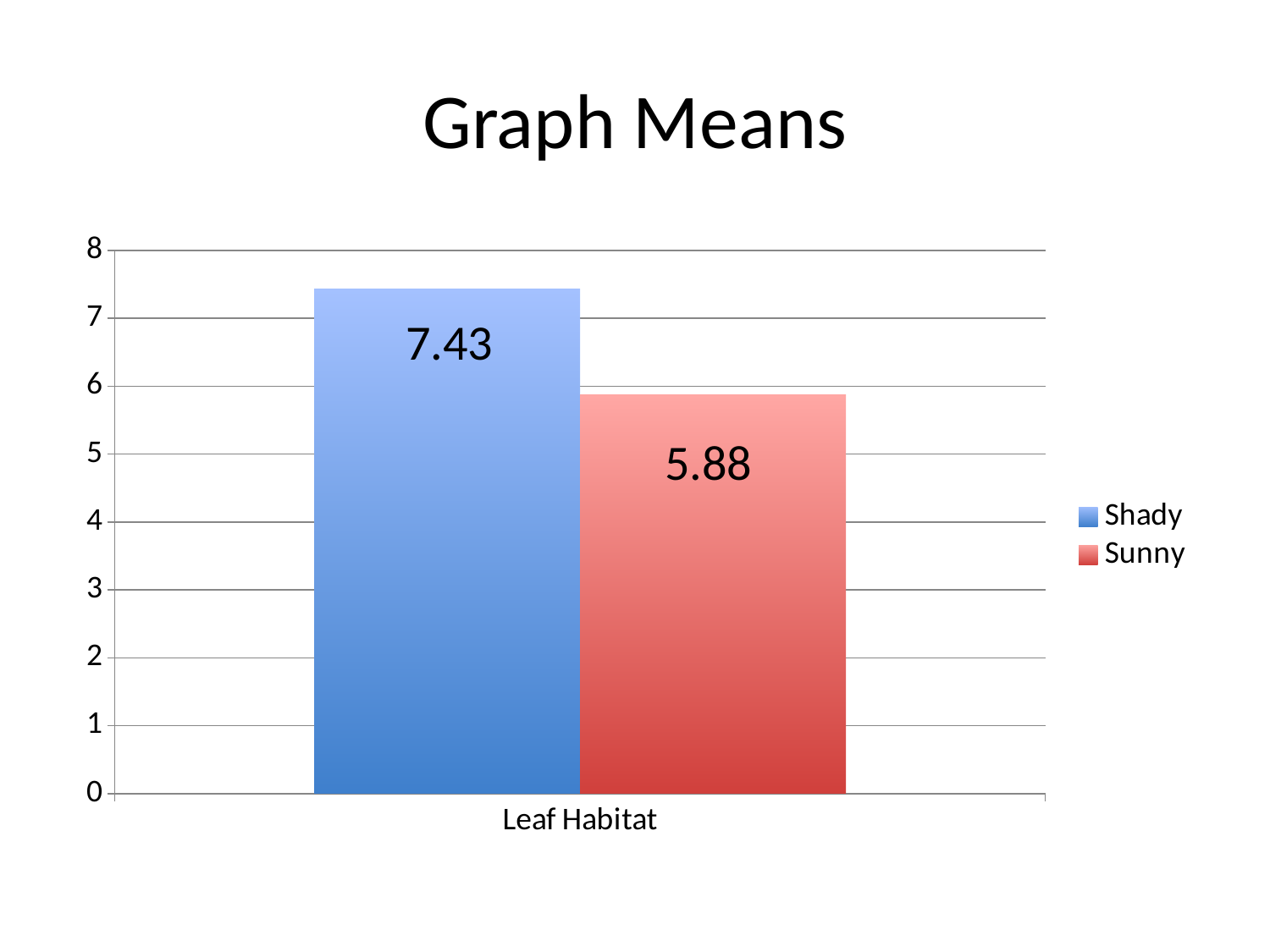
What is the difference between the Shady and Sunny values? 1.55 What is the value for Sunny? 5.88 Which series has the higher value, Shady or Sunny? Shady What is the value for Shady? 7.43 What kind of chart is shown on the slide? bar chart What is the title of the slide? Graph Means Which series has the lowest value? Sunny What is the category label on the x axis? Leaf Habitat Which series has the highest value? Shady How many series does the legend list? 2 Is the value for Sunny greater or less than 6? less Is the value for Shady greater or less than 7? greater